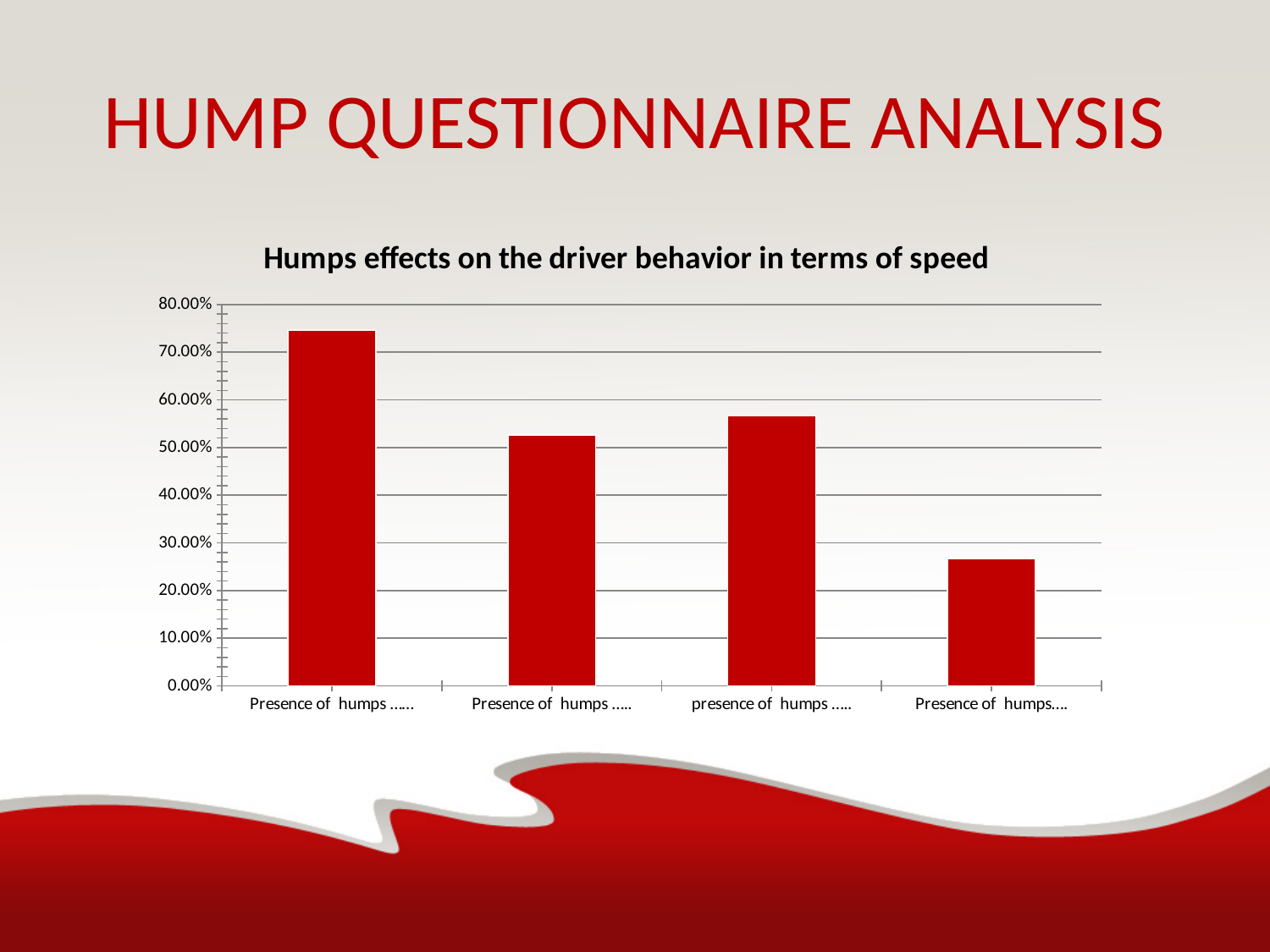
What is the title of the chart? Humps effects on the driver behavior in terms of speed Which is larger, the third bar or the fourth bar? the third bar Which bar is the tallest in the chart? the first (leftmost) bar Which bar is the shortest in the chart? the fourth (rightmost) bar Which is larger, the first bar or the second bar? the first bar What kind of chart is shown on the slide? bar chart Is the value of the first (leftmost) bar greater or less than 70.00%? greater Is the value of the third bar greater or less than 50.00%? greater Is the value of the second bar greater or less than 60.00%? less How many bars are plotted in the chart? 4 What colour are the bars in the chart? red